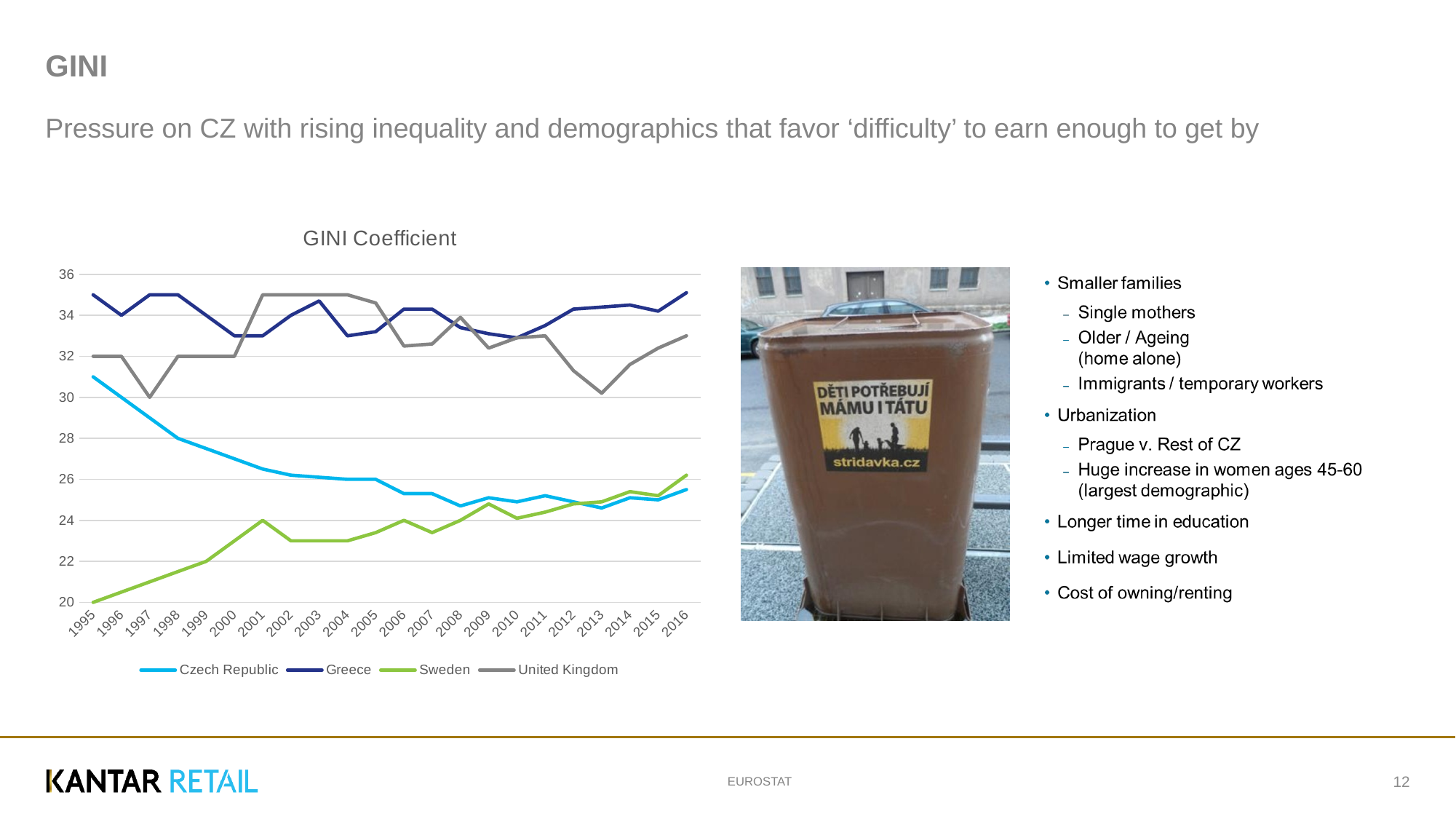
How many years are shown on the x axis of the GINI Coefficient chart? 22 What kind of chart is the GINI Coefficient chart? line chart How many series does the legend of the GINI Coefficient chart list? 4 What is the GINI coefficient for the United Kingdom in 1997? 30 Does the GINI coefficient for Sweden rise or fall from 1995 to 2016? rise In 2016, which has the larger GINI coefficient: Greece or the United Kingdom? Greece What is the GINI coefficient for Sweden in 1995? 20 Is the GINI coefficient for the Czech Republic in 1995 greater or less than 30? greater Which country has the highest GINI coefficient in 2016? Greece What is the GINI coefficient for the Czech Republic in 1998? 28 Does the GINI coefficient for the Czech Republic rise or fall from 1995 to 2016? fall Which country has the lowest GINI coefficient in 1995? Sweden